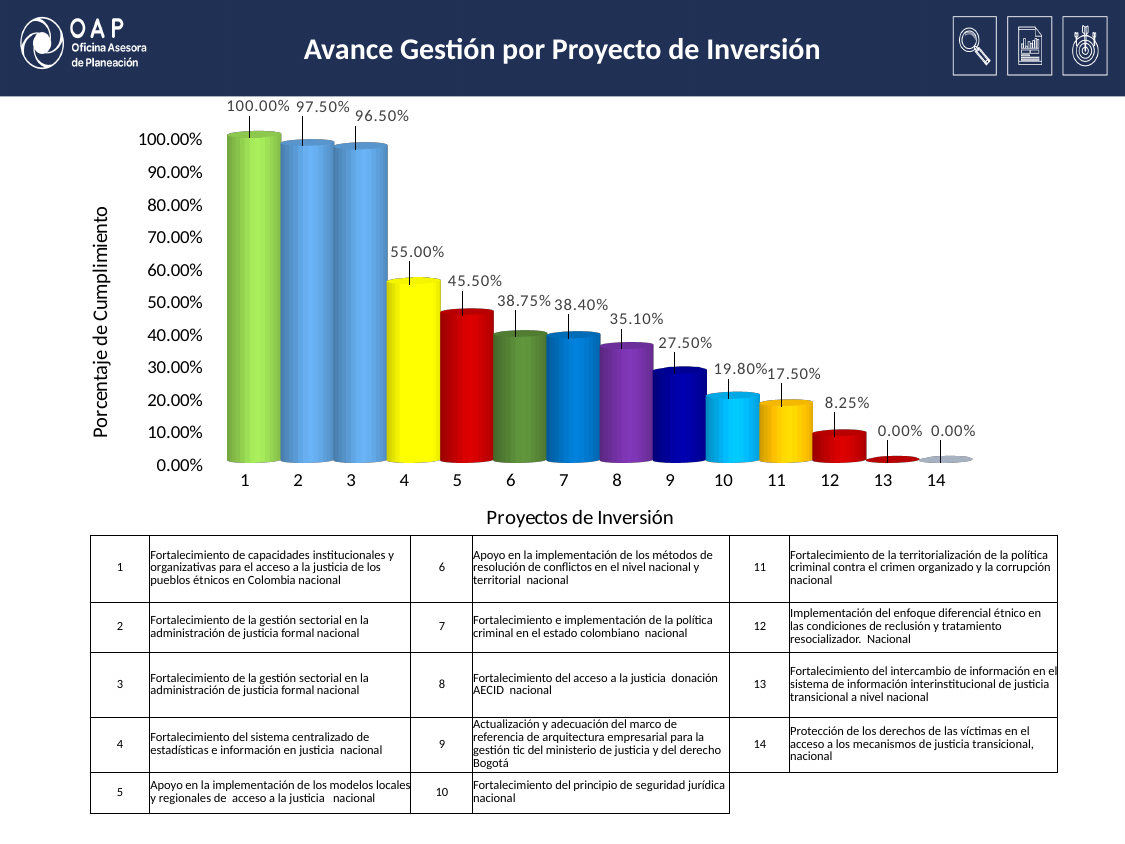
What is the difference between the values for project 1 and project 4? 45.00% What is the value for project 12 in the chart? 8.25% Which is larger, the value for project 9 or the value for project 12? project 9 What is the value for project 4 in the chart? 55.00% What is the value for project 9 in the chart? 27.50% Which projects have the lowest value in the chart? 13 and 14 Which project has the highest value in the chart? 1 What is the label of the vertical axis of the chart? Porcentaje de Cumplimiento Do the values rise or fall from project 1 to project 14 along the x axis? fall What kind of chart is shown on the slide? bar chart How many projects are plotted in the chart? 14 What is the difference between the values for project 4 and project 5? 9.50%